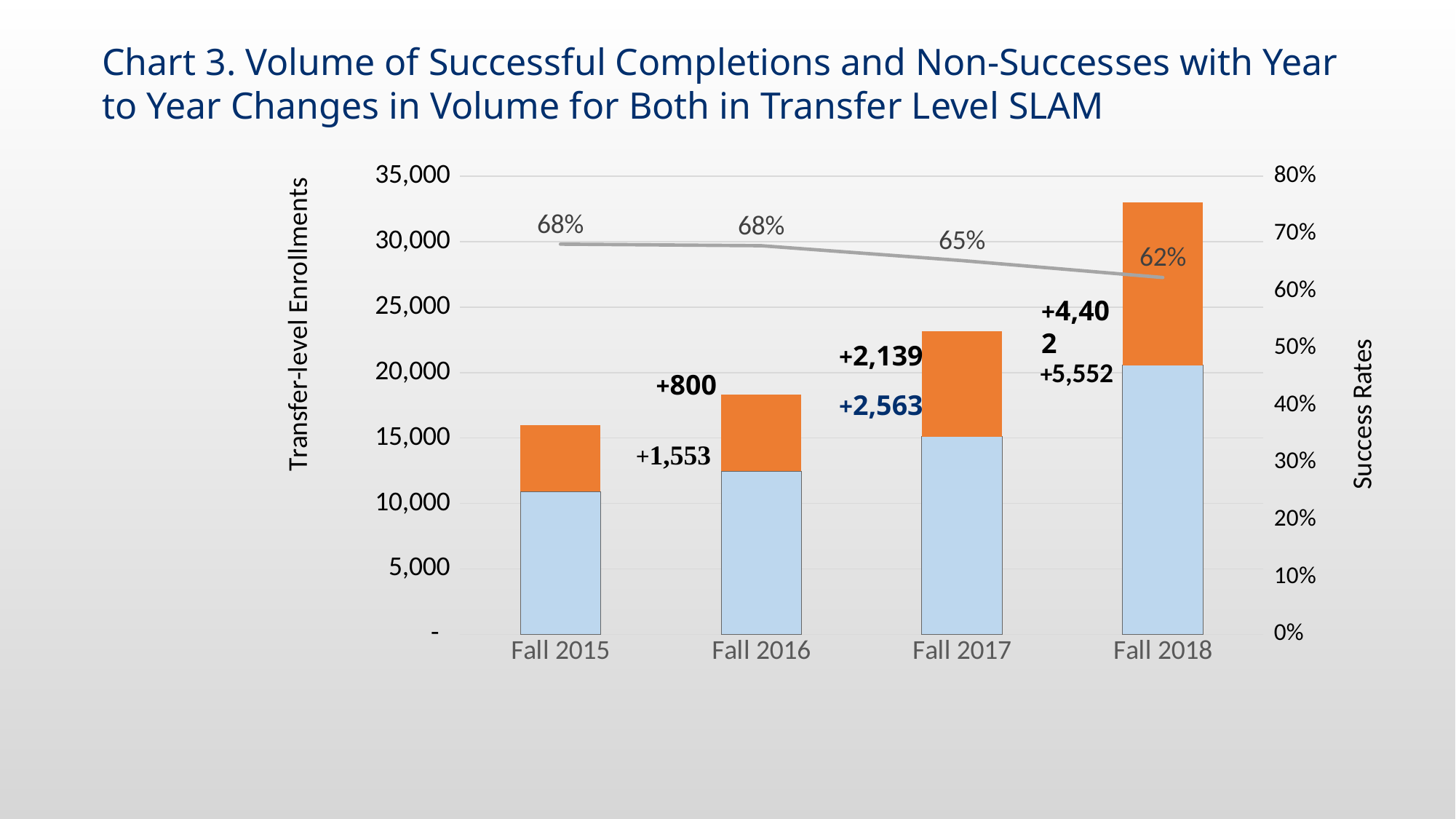
Does the success rate line rise or fall from Fall 2015 to Fall 2018? fall What is the title of the left vertical axis? Transfer-level Enrollments What is the success rate shown for Fall 2017? 65% What is the success rate shown for Fall 2015? 68% What kind of chart is used to show the enrollment volumes? bar chart Which term has the tallest total enrollment bar? Fall 2018 Is the total enrollment bar for Fall 2018 greater or less than 30,000? greater Which term has the lowest success rate? Fall 2018 Is the total enrollment bar for Fall 2015 greater or less than 20,000? less What is the success rate shown for Fall 2018? 62% By how many percentage points does the success rate drop from Fall 2015 to Fall 2018? 6 percentage points How many terms are shown on the x axis? 4